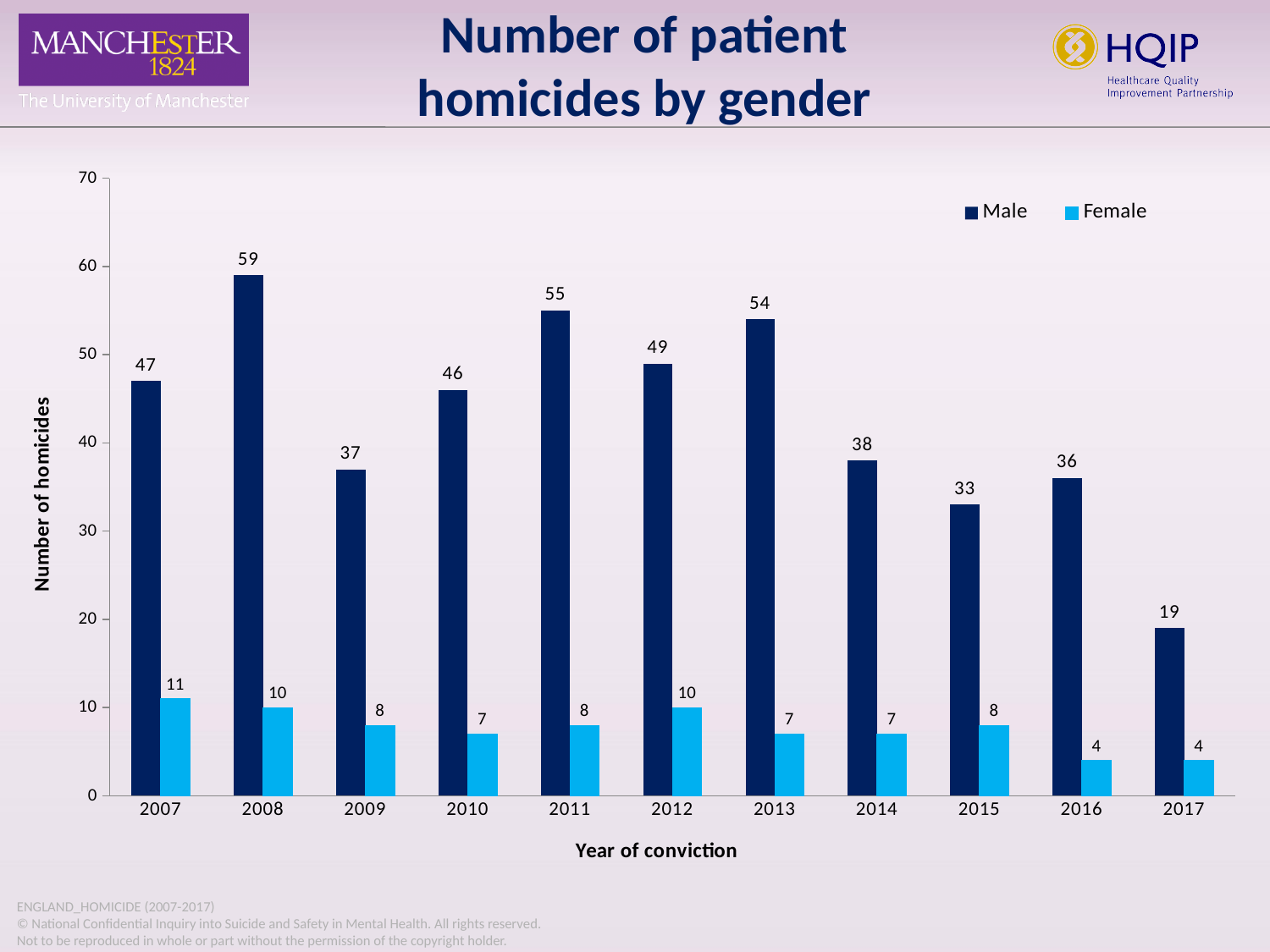
Which year has the highest number of female patient homicides? 2007 How many years are shown on the x axis? 11 What is the number of female patient homicides in 2012? 10 Which is larger, the number of male homicides in 2011 or in 2012? 2011 Which year has the lowest number of male patient homicides? 2017 Which year has the highest number of male patient homicides? 2008 How many series does the legend list? 2 What is the total number of patient homicides (male plus female) in 2016? 40 What is the label of the y axis? Number of homicides What kind of chart is shown on the slide? Bar chart What is the difference between male and female patient homicides in 2013? 47 What is the number of male patient homicides in 2008? 59